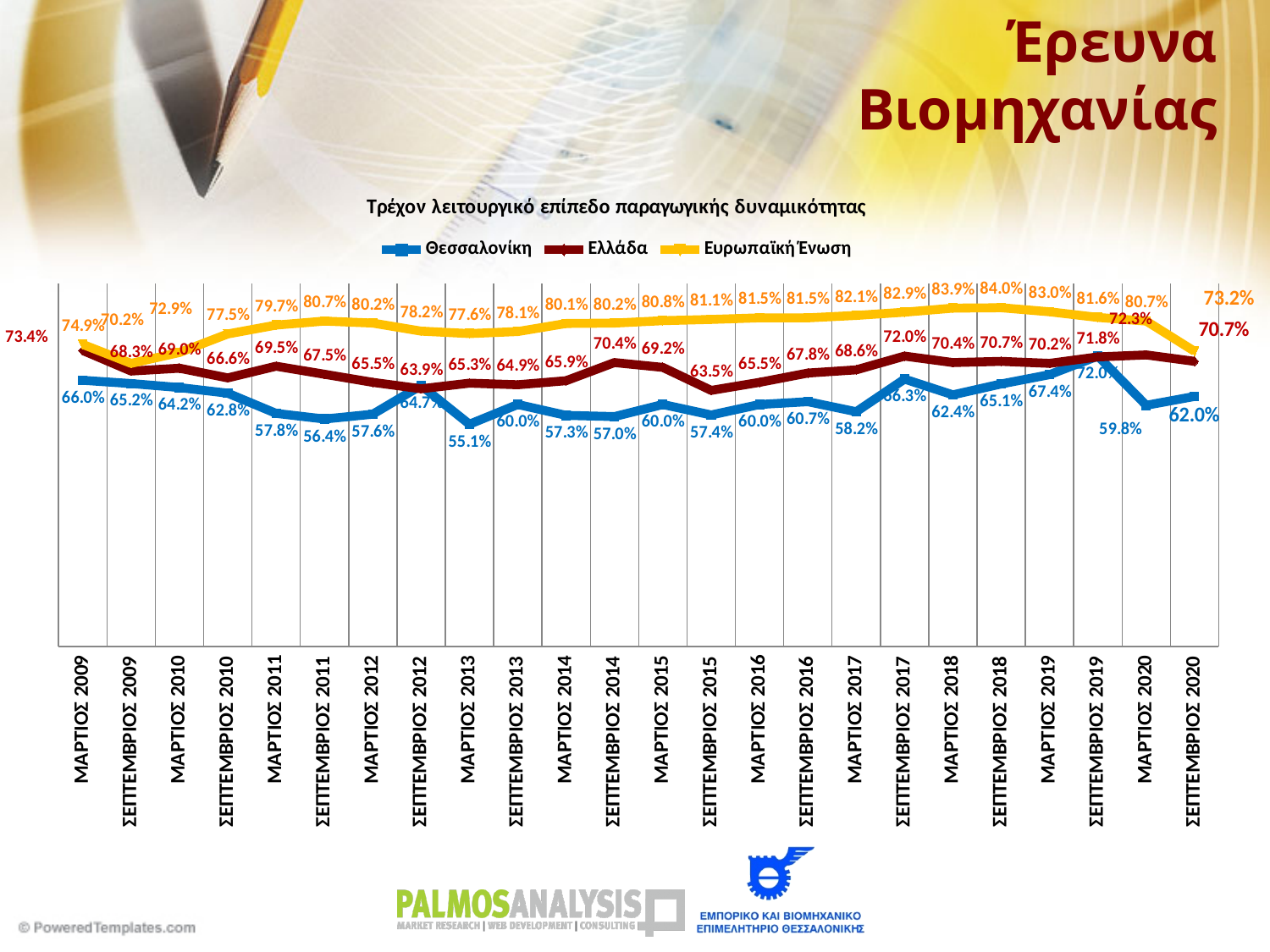
What colour is used for the Ευρωπαϊκή Ένωση series? Yellow How many series does the legend list? 3 What is the value for Θεσσαλονίκη in ΜΑΡΤΙΟΣ 2013? 55.1% What is the value for Θεσσαλονίκη in ΣΕΠΤΕΜΒΡΙΟΣ 2020? 62.0% What is the difference between the Ευρωπαϊκή Ένωση and Θεσσαλονίκη values in ΣΕΠΤΕΜΒΡΙΟΣ 2020? 11.2 percentage points In which period does the Θεσσαλονίκη series reach its lowest value? ΜΑΡΤΙΟΣ 2013 What is the value for Ελλάδα in ΜΑΡΤΙΟΣ 2009? 73.4% In which period does the Ευρωπαϊκή Ένωση series reach its highest value? ΣΕΠΤΕΜΒΡΙΟΣ 2018 What is the value for Ευρωπαϊκή Ένωση in ΣΕΠΤΕΜΒΡΙΟΣ 2018? 84.0% In ΜΑΡΤΙΟΣ 2020, which is higher: Ελλάδα or Θεσσαλονίκη? Ελλάδα What kind of chart is shown on the slide? Line chart How many time points are shown on the x axis? 24